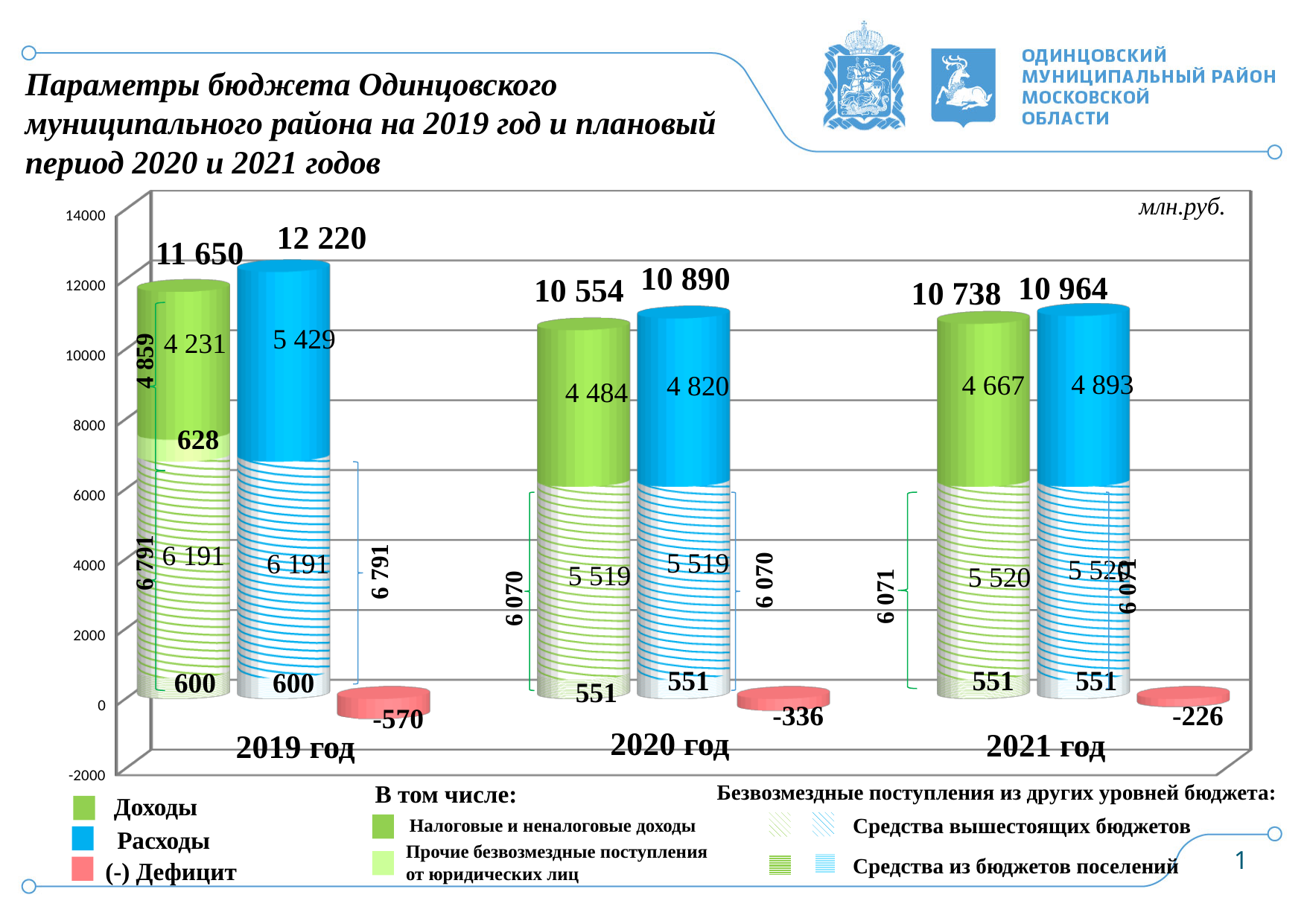
How many years are shown on the x axis? 3 What is the total value of the Доходы bar for 2019 год? 11 650 Which is larger for 2021 год, Доходы or Расходы? Расходы What is the Дефицит value shown for 2020 год? -336 Is the Доходы bar for 2020 год greater or less than 12000? less What is the total value of the Расходы bar for 2021 год? 10 964 What kind of chart is shown on the slide? Stacked bar chart What is the difference between Расходы and Доходы for 2019 год? 570 In which year is the Расходы bar the highest? 2019 год In which year is the Доходы bar the lowest? 2020 год What unit of measurement is indicated in the top right corner of the chart? млн.руб.